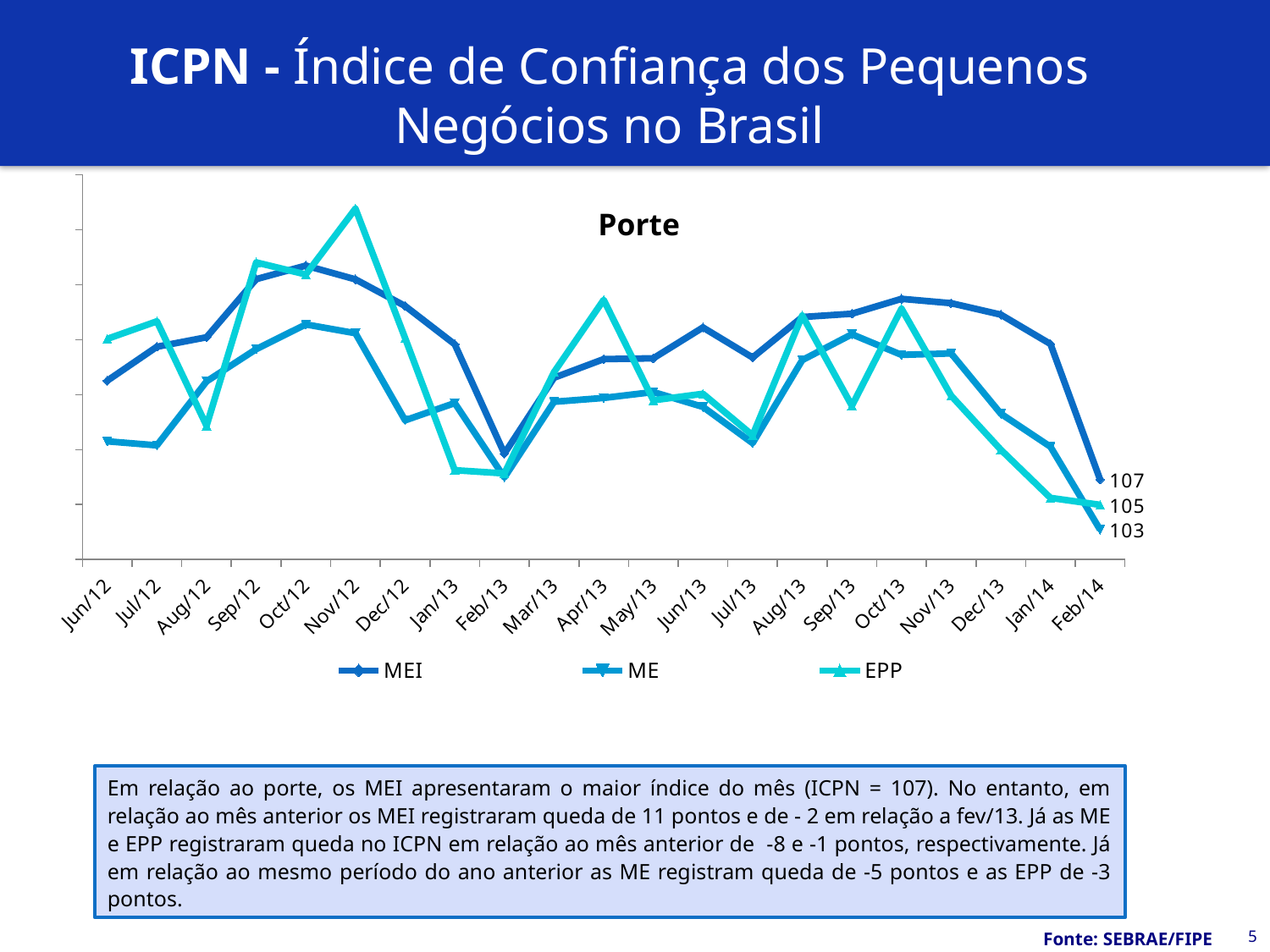
How many months are shown on the x axis? 21 Which series has the lowest value at Feb/14? ME What is the value of the MEI series at Feb/14? 107 What is the difference between the MEI and EPP values at Feb/14? 2 Does the MEI series rise or fall from Oct/13 to Feb/14? Fall What is the difference between the MEI and ME values at Feb/14? 4 What kind of chart is shown on the slide? Line chart How many series does the legend list? 3 What is the value of the ME series at Feb/14? 103 Which series has the highest value at Feb/14? MEI At Feb/14, which is larger: the ME value or the EPP value? EPP What is the value of the EPP series at Feb/14? 105